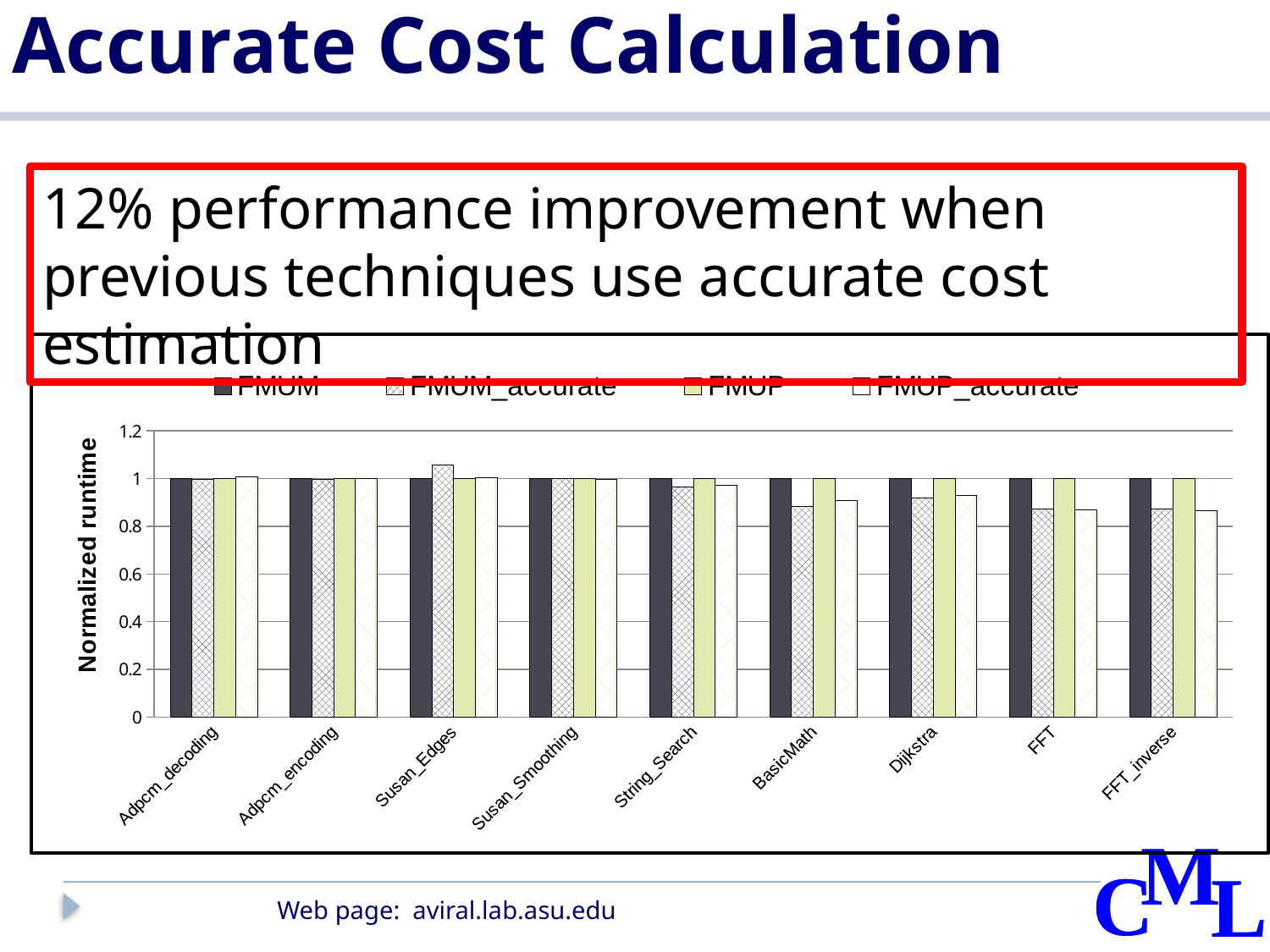
Is the FMUP_accurate value for FFT greater or less than 0.8? greater How many series does the chart's legend list? 4 For BasicMath, which is larger: the FMUM bar or the FMUM_accurate bar? FMUM Is the FMUM_accurate value for BasicMath greater or less than 1? less Is the FMUM_accurate value for Susan_Edges greater or less than 1? greater For Susan_Edges, which is larger: the FMUM bar or the FMUM_accurate bar? FMUM_accurate What is the normalized runtime of FMUM for Adpcm_decoding? 1 What kind of chart is shown on the slide? bar chart What is the normalized runtime of FMUP for Dijkstra? 1 Which category has the highest FMUM_accurate value? Susan_Edges What is the label of the chart's vertical axis? Normalized runtime How many benchmark categories are shown on the x axis of the chart? 9